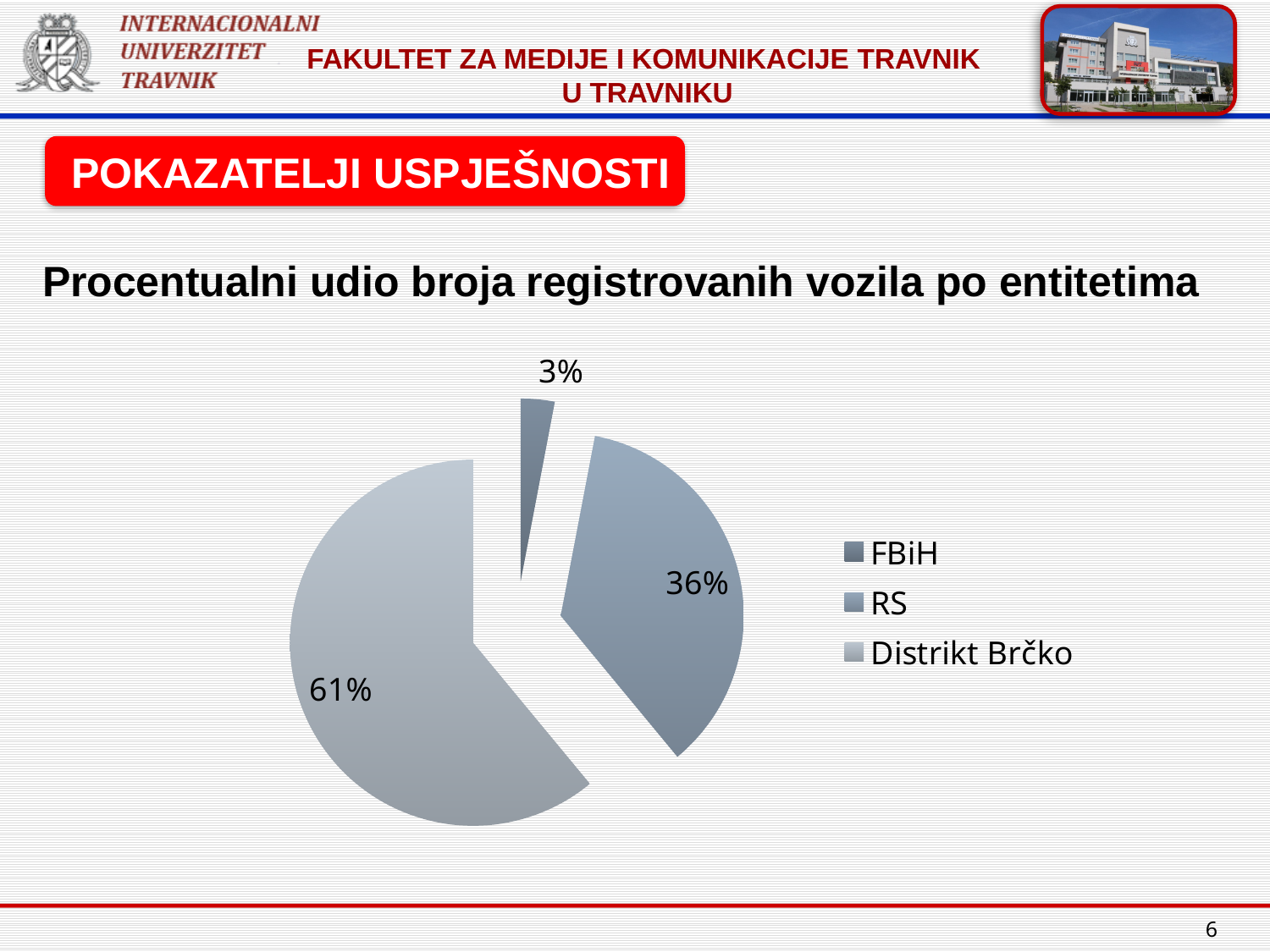
How many entries does the chart legend list? 3 What share of the pie does the slice labelled RS have? 36% Which slice of the pie chart is the largest? Distrikt Brčko Which slice of the pie chart is the smallest? FBiH What kind of chart is shown on the slide? pie chart What share of the pie does the slice labelled Distrikt Brčko have? 61% What share of the pie does the slice labelled FBiH have? 3% How many slices does the pie chart have? 3 Which is larger, the RS slice or the FBiH slice? RS What is the difference in percentage points between the 61% slice and the 36% slice? 25 Which legend entry is listed first in the chart legend? FBiH What is the title of the chart on the slide? Procentualni udio broja registrovanih vozila po entitetima